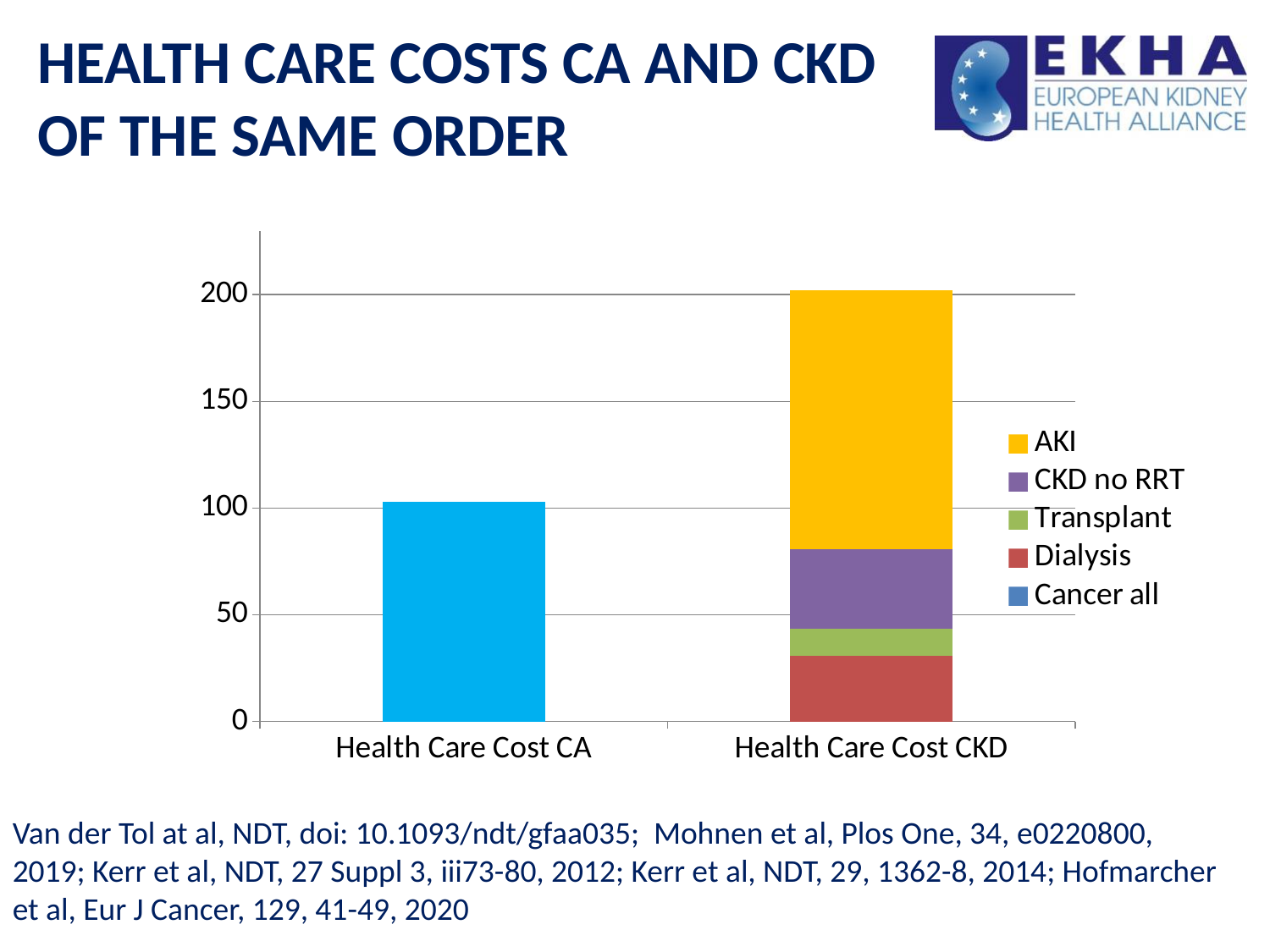
Which legend entry is listed last in the chart's legend? Cancer all Is the Dialysis segment of the Health Care Cost CKD bar greater or less than 50? less Is the AKI segment of the Health Care Cost CKD bar greater or less than 100? greater Is the total value for Health Care Cost CKD greater or less than 150? greater How many series does the chart's legend list? 5 How many categories are shown on the x axis of the chart? 2 Which category has the taller bar, Health Care Cost CA or Health Care Cost CKD? Health Care Cost CKD What colour represents AKI in the chart's legend? Yellow Which segment is the largest in the Health Care Cost CKD stacked bar? AKI Which category has the highest total bar in the chart? Health Care Cost CKD What kind of chart is shown on the slide? Stacked bar chart